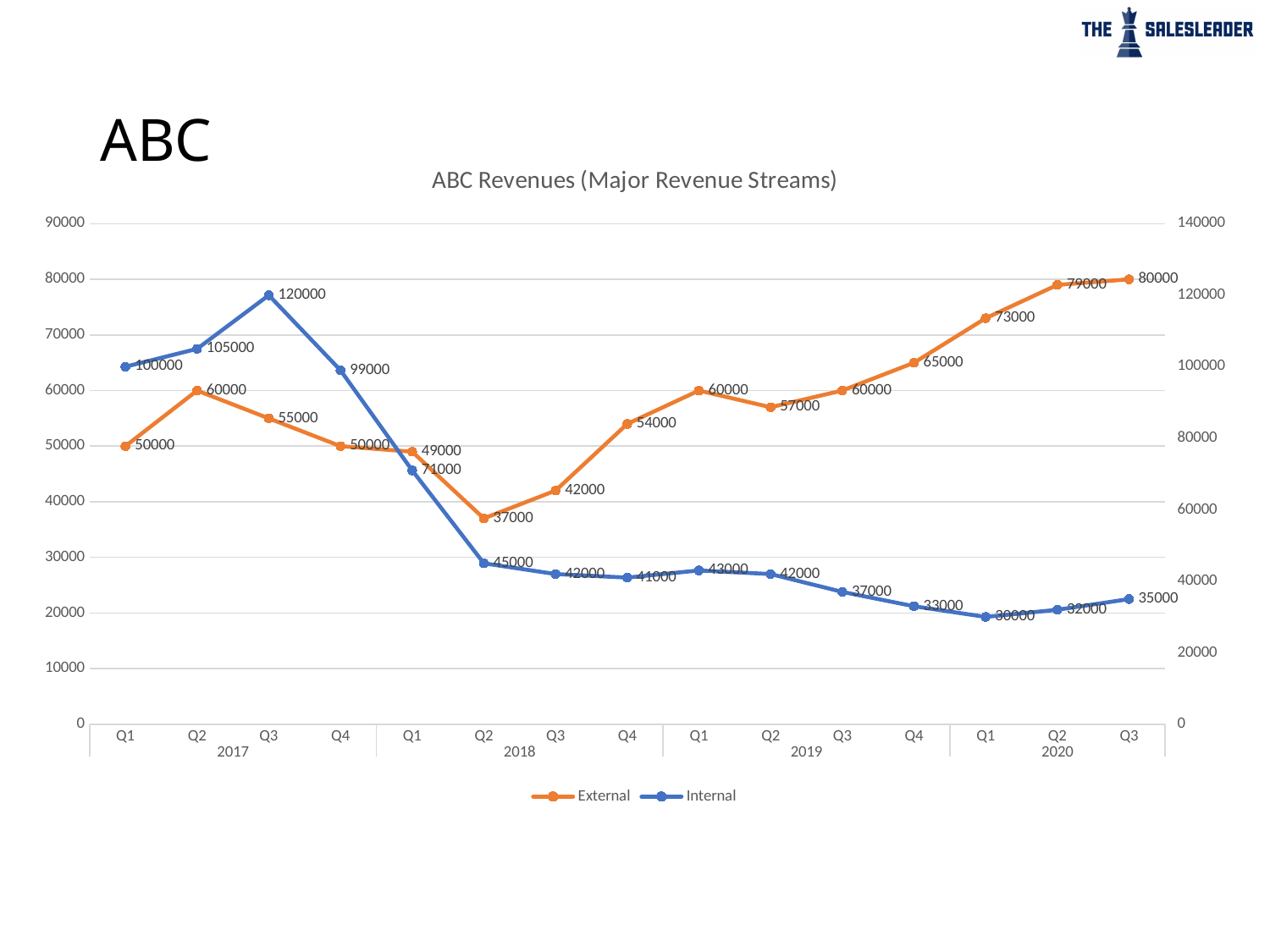
In which quarter does the Internal series reach its lowest value? Q1 2020 How many quarters are plotted on the x axis? 15 What is the difference between the External values for Q3 2020 and Q2 2018? 43000 What type of chart is shown on the slide? Line chart What is the External revenue value for Q3 2017? 55000 What is the Internal revenue value for Q1 2018? 71000 In which quarter does the Internal series reach its highest value? Q3 2017 What is the difference between the Internal values for Q3 2017 and Q4 2017? 21000 What is the External revenue value for Q2 2018? 37000 In which quarter does the External series reach its highest value? Q3 2020 Which is larger, the Internal value for Q2 2017 or the Internal value for Q4 2017? Q2 2017 How many series does the legend list? 2